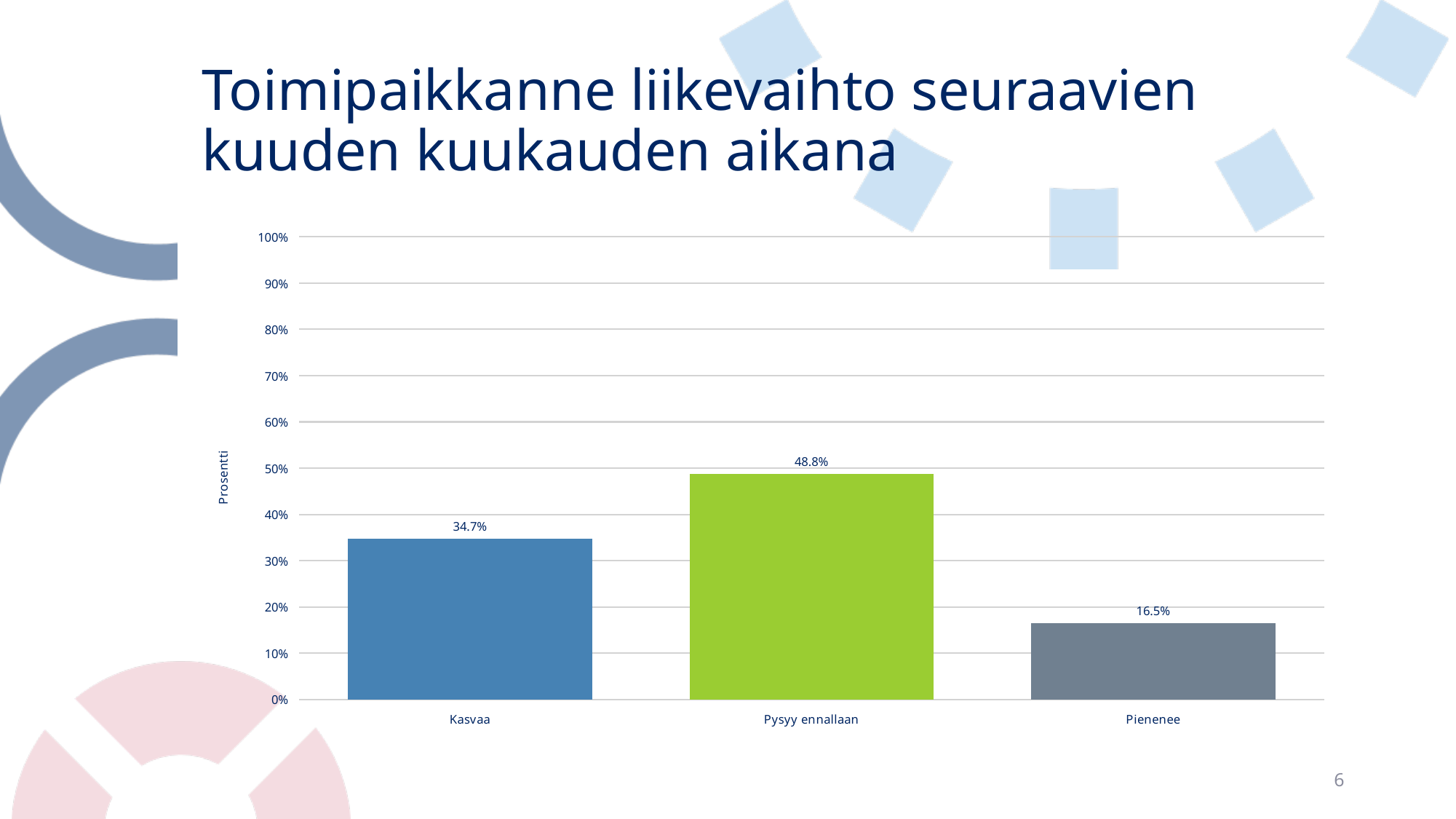
How many categories are shown on the x axis? 3 What is the value for Pienenee? 16.5% Which category has the highest value? Pysyy ennallaan Is the value for Pysyy ennallaan greater or less than 50%? less Which is larger, the value for Kasvaa or the value for Pienenee? Kasvaa What is the label of the vertical axis? Prosentti What is the value for Pysyy ennallaan? 48.8% What is the difference between the values for Pysyy ennallaan and Kasvaa? 14.1% What kind of chart is shown on the slide? bar chart What is the difference between the values for Kasvaa and Pienenee? 18.2% What is the value for Kasvaa? 34.7% Which category has the lowest value? Pienenee